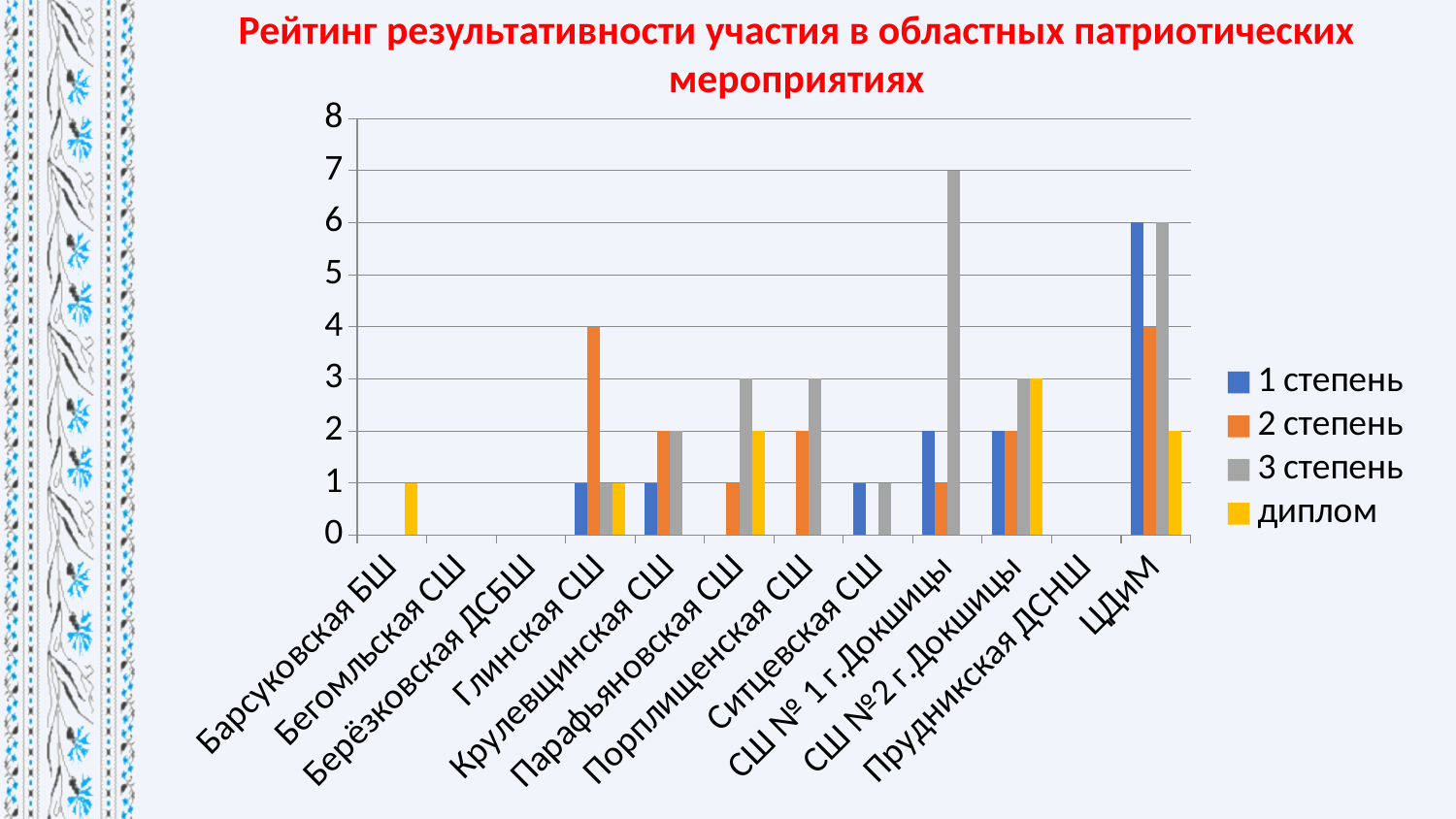
How many categories are shown on the x axis? 12 What type of chart is shown on the slide? bar chart Which is larger: the "2 степень" value for Глинская СШ or the "2 степень" value for Крулевщинская СШ? Глинская СШ What is the value of "диплом" for СШ №2 г.Докшицы? 3 What is the value of "1 степень" for ЦДиМ? 6 Which category has the highest value for "1 степень"? ЦДиМ What is the value of "2 степень" for Глинская СШ? 4 Which category has the highest value for "3 степень"? СШ № 1 г.Докшицы How many series does the legend list? 4 What is the value of "3 степень" for СШ № 1 г.Докшицы? 7 What is the difference between the "3 степень" value for СШ № 1 г.Докшицы and the "3 степень" value for ЦДиМ? 1 What is the title of the chart? Рейтинг результативности участия в областных патриотических мероприятиях